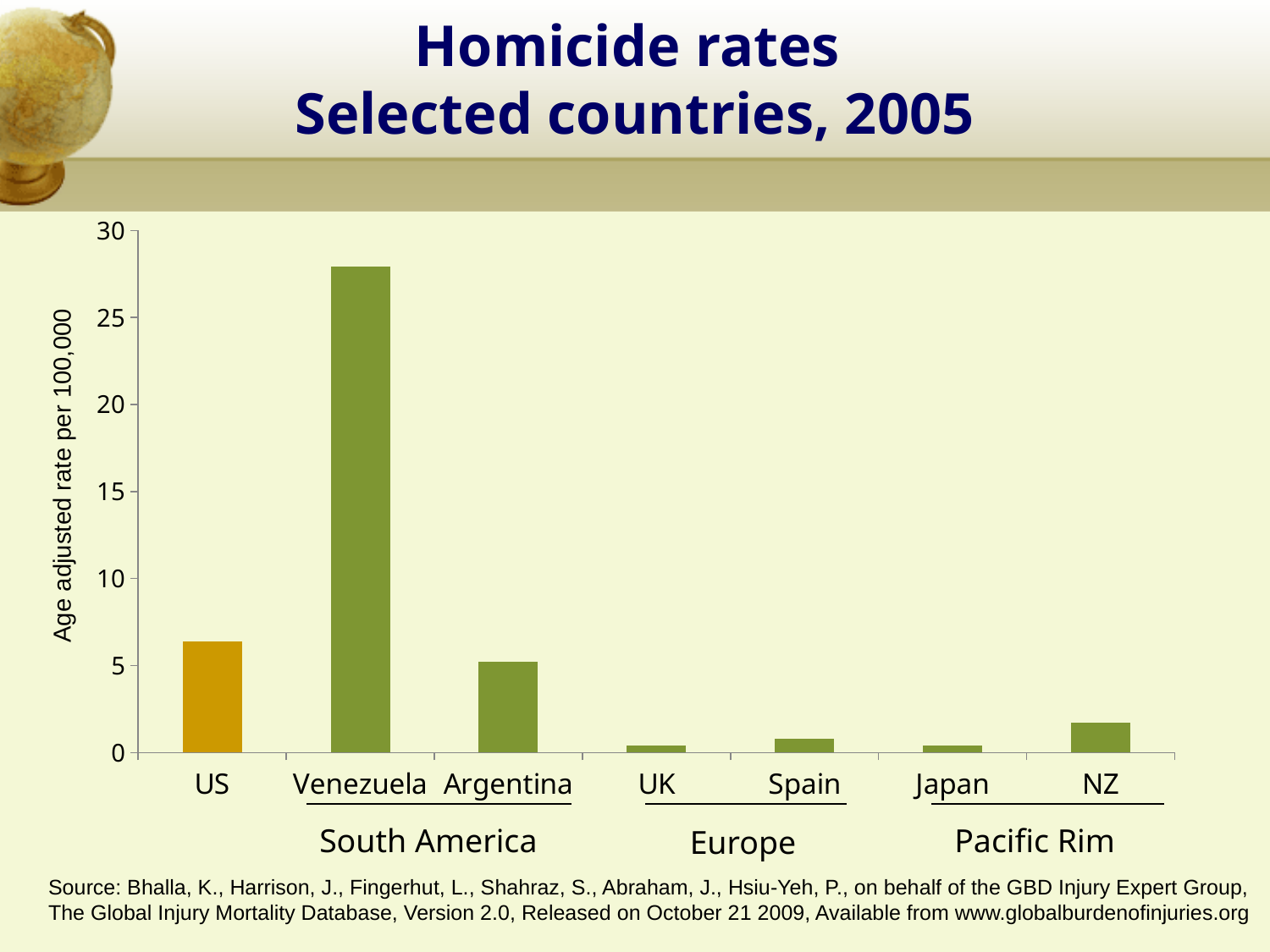
Is the value for Venezuela greater or less than 25? greater Is the value for Spain greater or less than 5? less Is the value for Argentina greater or less than 10? less How many countries are shown in the chart? 7 Which regional group includes Japan and NZ? Pacific Rim Which country has the highest homicide rate in the chart? Venezuela Which has a higher homicide rate, US or Argentina? US Which has a higher homicide rate, NZ or Spain? NZ What is the label of the vertical axis? Age adjusted rate per 100,000 What kind of chart is shown on the slide? bar chart